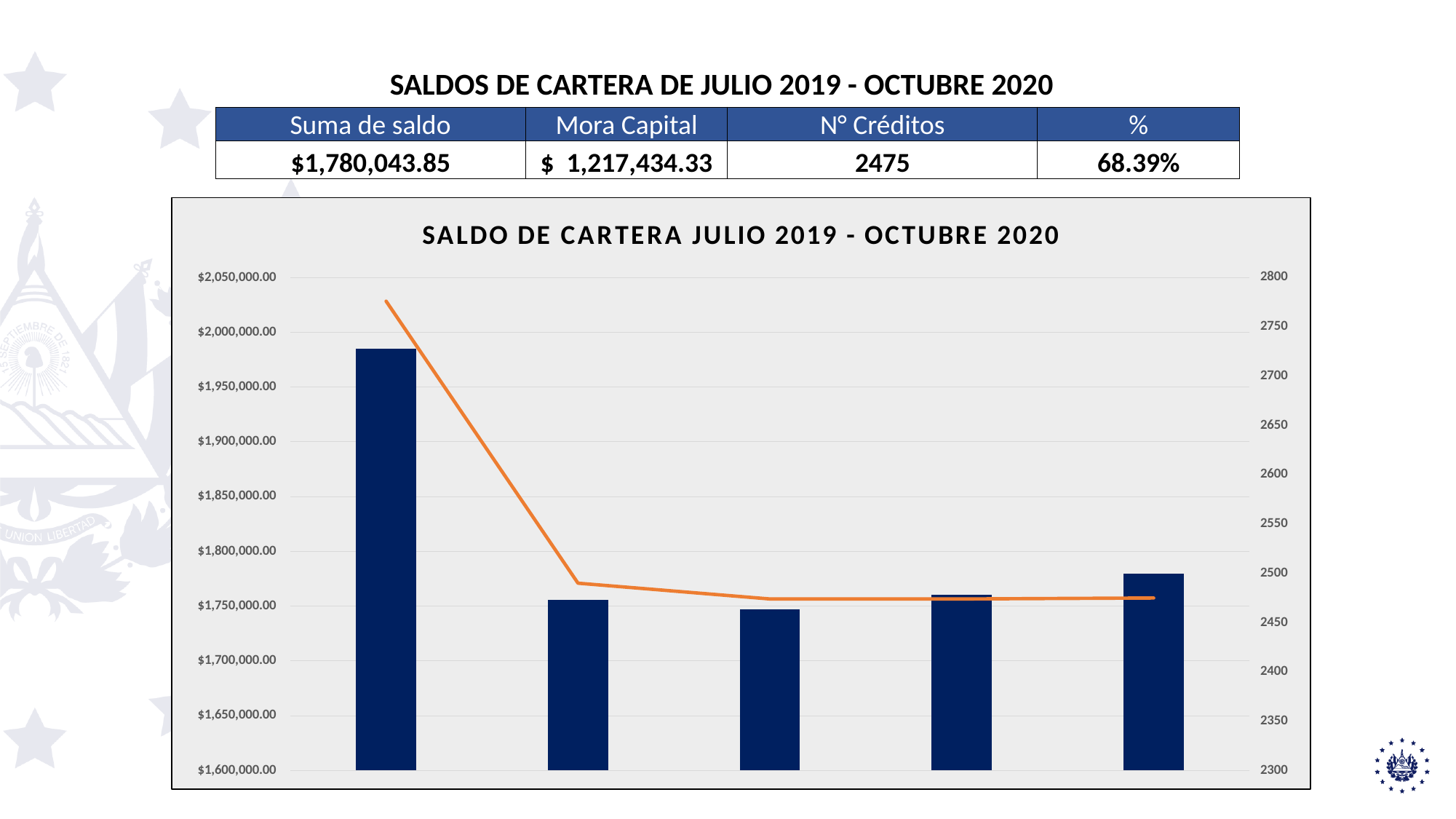
How many bars are plotted in the chart? 5 Is the value of the first (leftmost) bar greater or less than $1,950,000.00? greater What is the title of the chart? SALDO DE CARTERA JULIO 2019 - OCTUBRE 2020 Which bar is the tallest in the chart? The first (leftmost) bar Does the orange line rise or fall from the first point to the last point? It falls On the right-hand axis, is the first point of the orange line greater or less than 2750? greater Is the value of the second bar greater or less than $1,800,000.00? less Which is larger, the first bar or the last bar? The first bar What colour are the bars in the chart? Dark navy blue What kind of chart is shown on the slide? A bar chart combined with a line